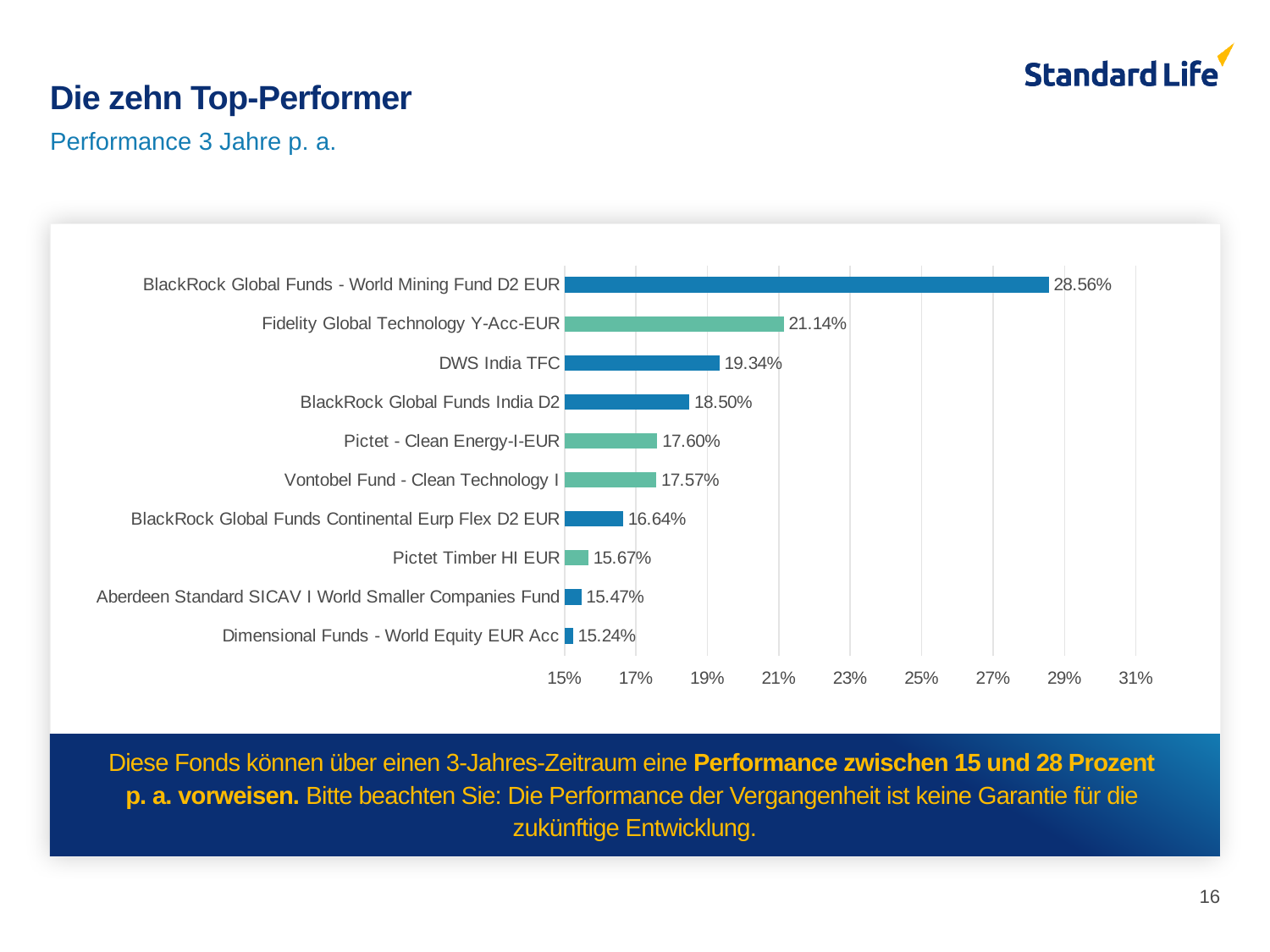
Which fund has the highest performance in the chart? BlackRock Global Funds - World Mining Fund D2 EUR What kind of chart is shown on the slide? Bar chart What is the difference between the highest and lowest values in the chart? 13.32% What value is shown for Pictet Timber HI EUR? 15.67% What is the subtitle of the slide describing the chart's measure? Performance 3 Jahre p. a. How many funds are shown in the chart? 10 What is the 3-year p.a. performance shown for BlackRock Global Funds - World Mining Fund D2 EUR? 28.56% What is the difference between the values for Fidelity Global Technology Y-Acc-EUR and BlackRock Global Funds India D2? 2.64% Is the value for Vontobel Fund - Clean Technology I greater or less than 19%? less Which fund has the lowest performance in the chart? Dimensional Funds - World Equity EUR Acc What value is shown for DWS India TFC? 19.34% Which has the larger value: Pictet - Clean Energy-I-EUR or BlackRock Global Funds Continental Eurp Flex D2 EUR? Pictet - Clean Energy-I-EUR